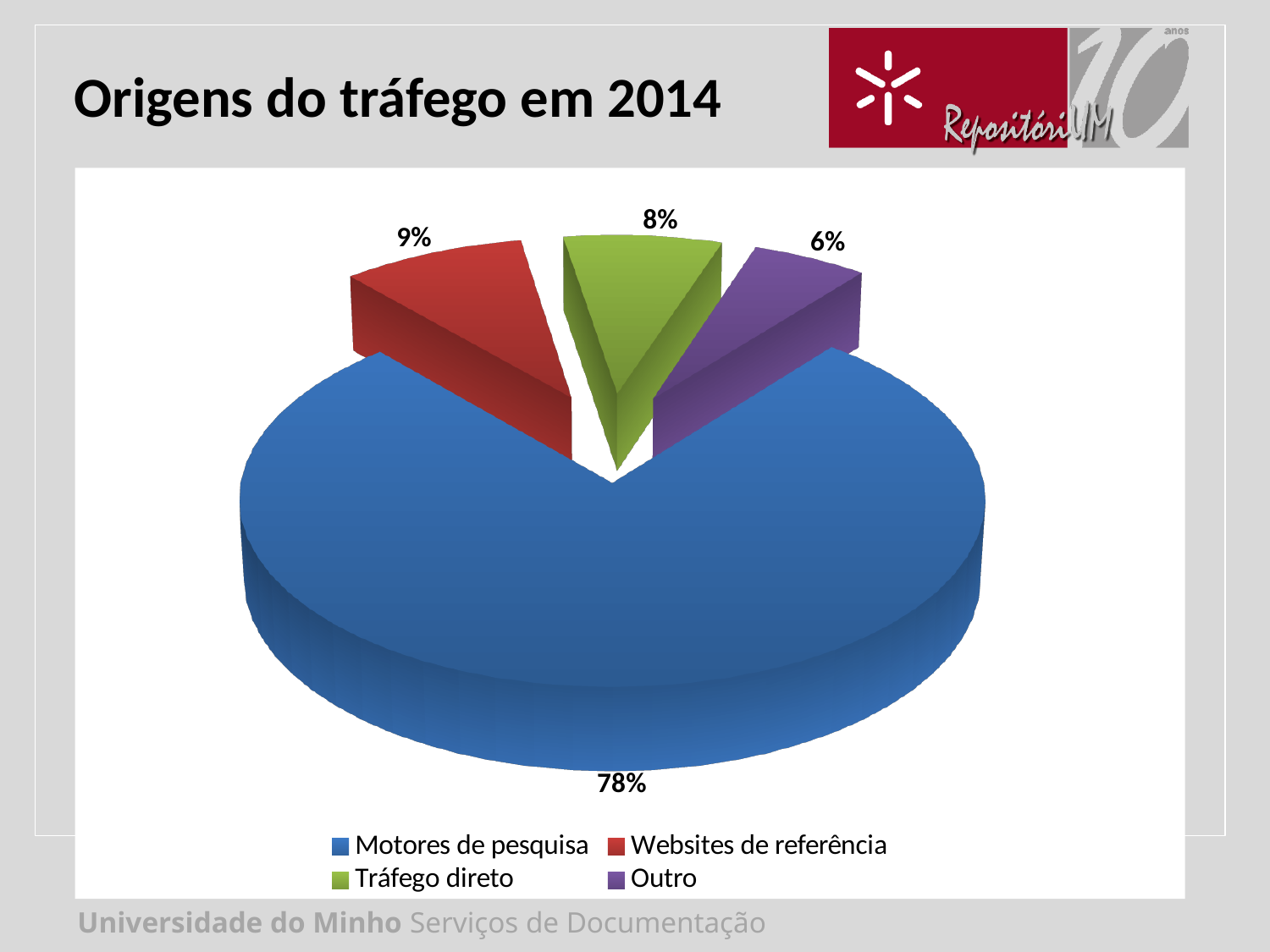
What share of traffic comes from Tráfego direto? 8% What type of chart is shown on the slide? pie chart What is the difference in percentage points between Motores de pesquisa and Websites de referência? 69 What share of traffic comes from Websites de referência? 9% What is the title of the slide containing the chart? Origens do tráfego em 2014 How many slices does the pie chart have? 4 Which traffic source has the largest share? Motores de pesquisa What share of traffic comes from Motores de pesquisa? 78% What colour is the slice for Tráfego direto? green Which traffic source has the smallest share? Outro Which is larger, the share for Websites de referência or the share for Outro? Websites de referência